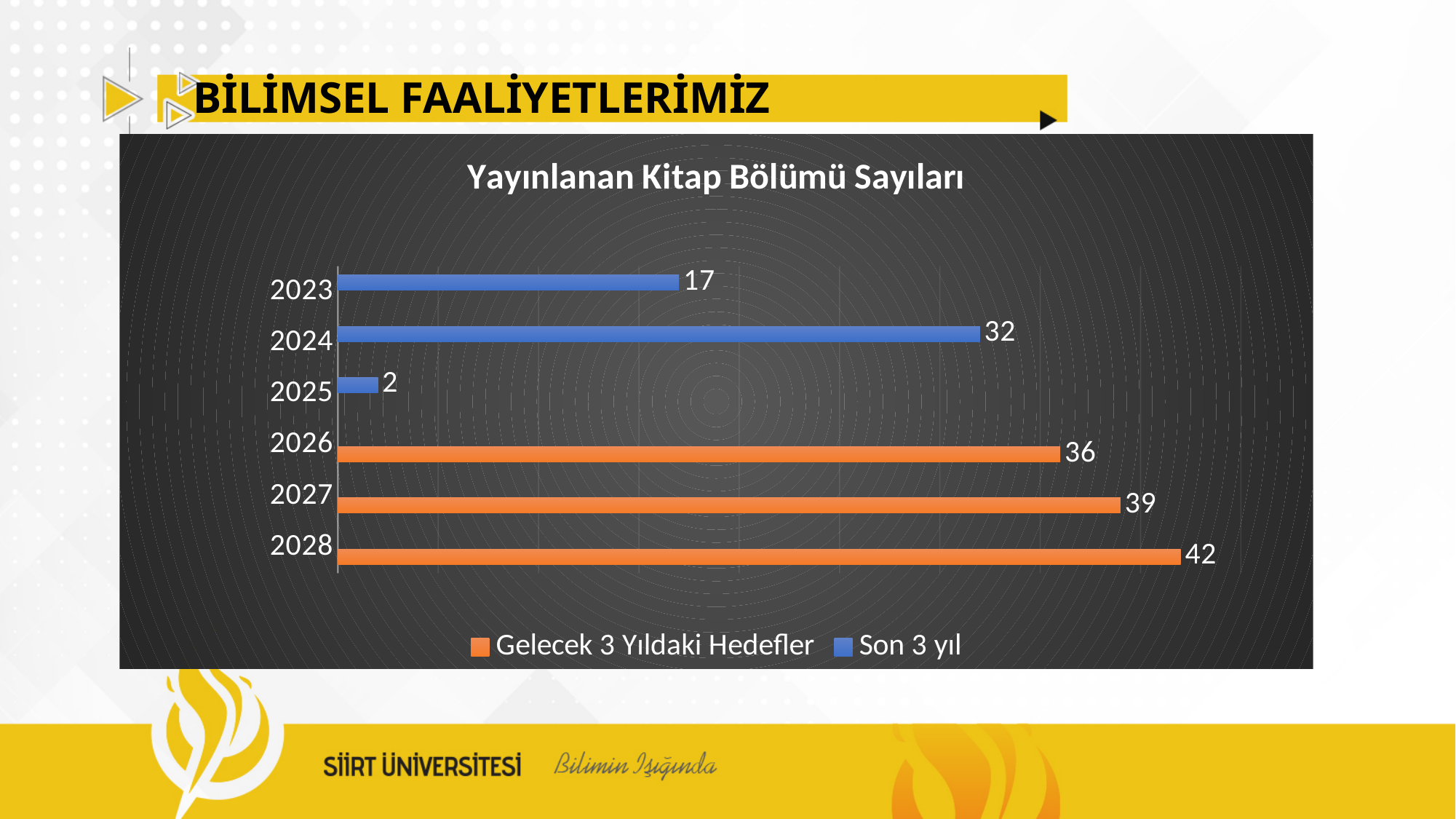
What is the title of the chart? Yayınlanan Kitap Bölümü Sayıları What is the difference between the values for 2024 and 2023? 15 What is the difference between the values for 2028 and 2026? 6 How many years are shown on the chart? 6 How many series does the legend list? 2 What is the value for 2028 in the chart? 42 What is the value for 2024 in the chart? 32 What kind of chart is shown on the slide? Bar chart Which year has the lowest value in the chart? 2025 Which is larger, the value for 2027 or the value for 2024? 2027 Which year has the highest value in the chart? 2028 What is the value for 2023 in the chart? 17